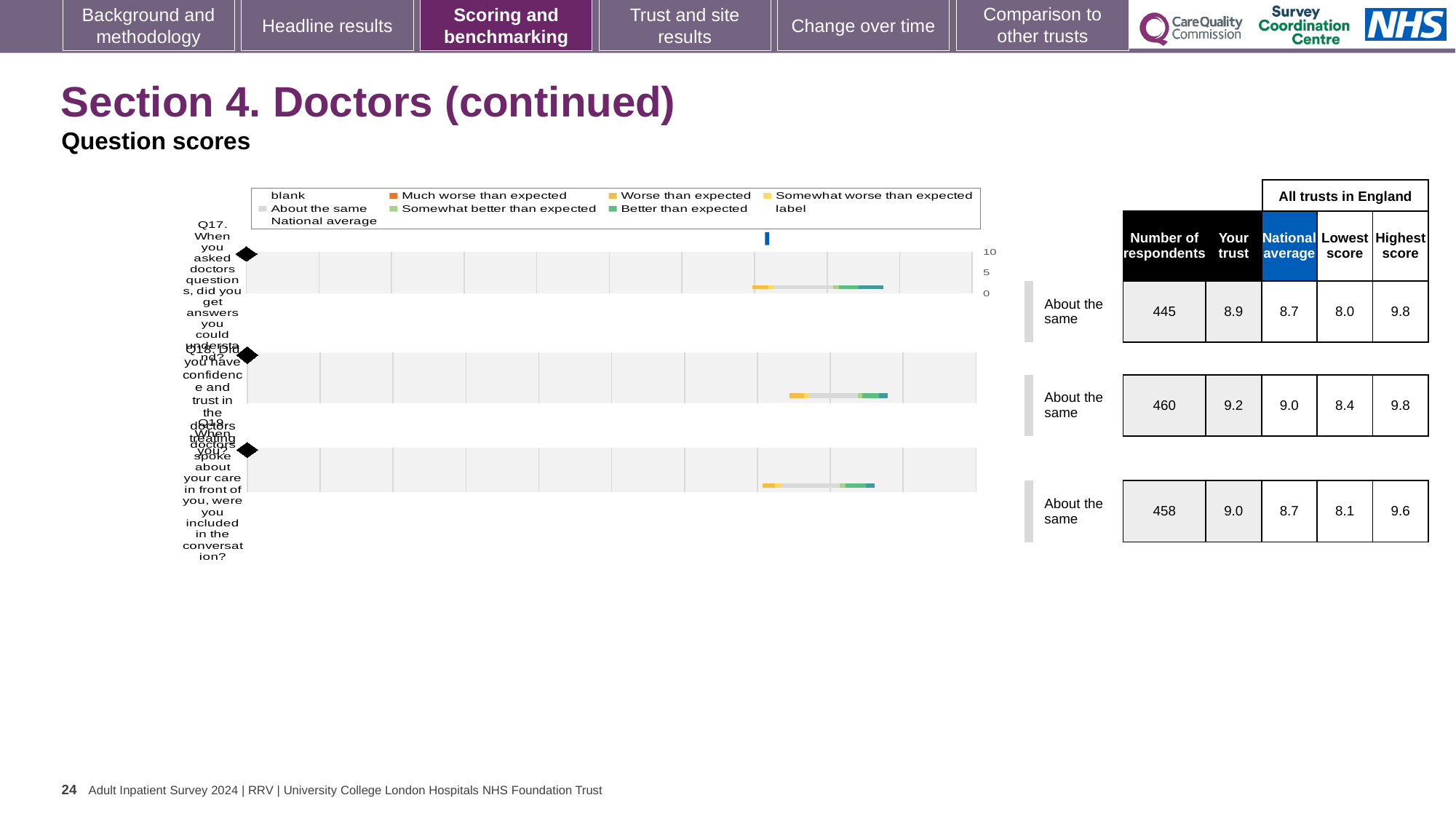
How many questions (categories) are plotted in the chart? 3 Which colour does the legend use for 'Much worse than expected'? orange For Q17, which is larger: the 'Your trust' score or the national average? Your trust What is the highest tick value shown on the chart's axis? 10 How many respondents answered Q19? 458 What kind of chart is shown on the slide? bar chart What benchmark category is shown for Q19? About the same What is the 'Your trust' score for Q17? 8.9 What is the difference between the 'Your trust' score and the national average for Q18? 0.2 Which question has the lowest 'Lowest score' value? Q17 Which question has the highest 'Your trust' score? Q18 What is the national average score for Q18? 9.0